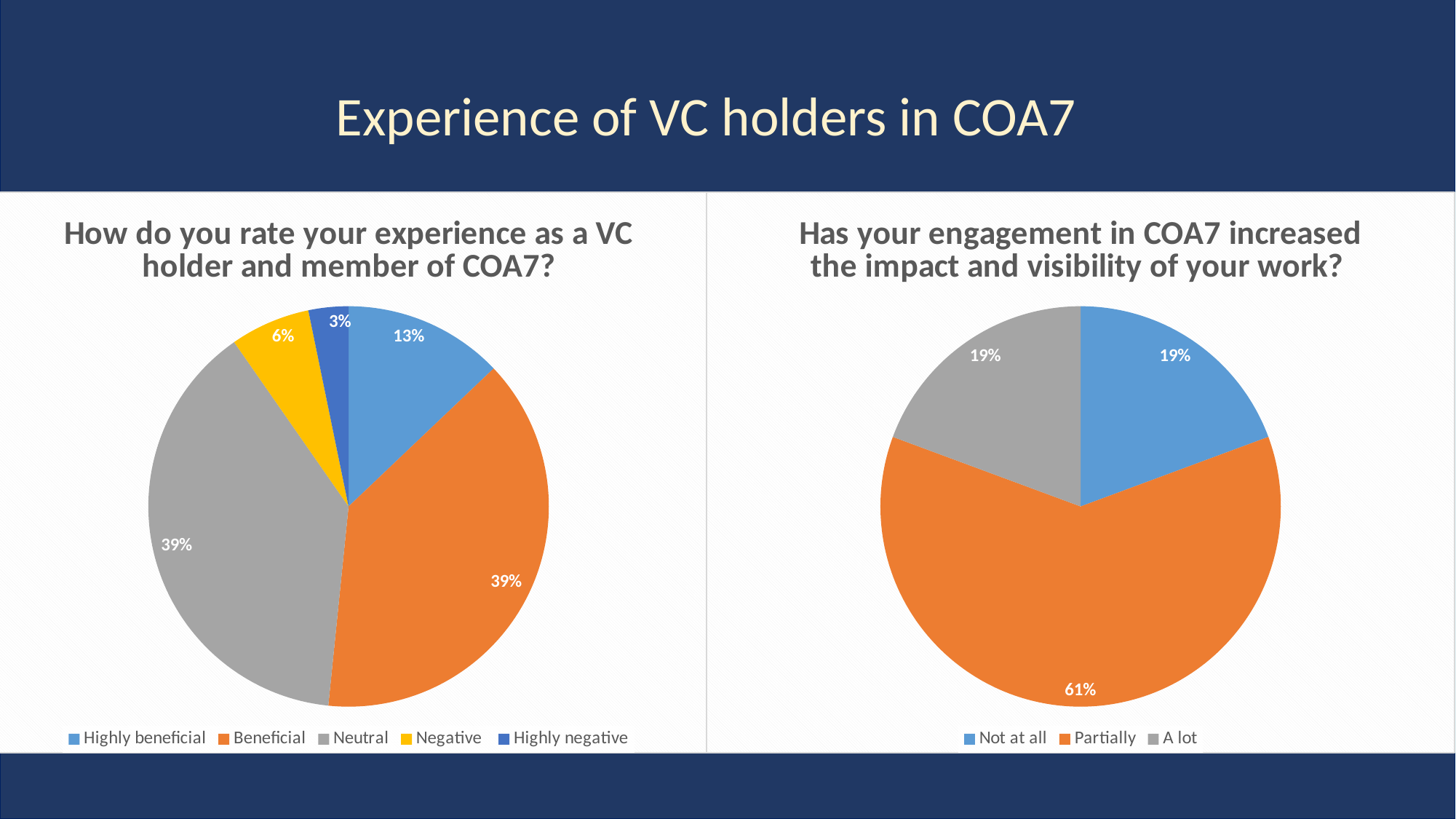
In the right chart ("Has your engagement in COA7 increased the impact and visibility of your work?"), which category has the largest slice? Partially In the right chart ("Has your engagement in COA7 increased the impact and visibility of your work?"), what share is labelled for Not at all? 19% In the left chart ("How do you rate your experience as a VC holder and member of COA7?"), what share is labelled for Highly beneficial? 13% In the right chart ("Has your engagement in COA7 increased the impact and visibility of your work?"), how many categories does the legend list? 3 In the right chart ("Has your engagement in COA7 increased the impact and visibility of your work?"), what share is labelled for Partially? 61% In the left chart ("How do you rate your experience as a VC holder and member of COA7?"), which is larger, Highly beneficial or Negative? Highly beneficial In the left chart ("How do you rate your experience as a VC holder and member of COA7?"), what share is labelled for Highly negative? 3% In the left chart ("How do you rate your experience as a VC holder and member of COA7?"), how many categories does the legend list? 5 In the left chart ("How do you rate your experience as a VC holder and member of COA7?"), what is the difference between the Highly beneficial and Negative shares? 7% In the left chart ("How do you rate your experience as a VC holder and member of COA7?"), what share is labelled for Negative? 6% In the left chart ("How do you rate your experience as a VC holder and member of COA7?"), which category has the smallest slice? Highly negative What kind of chart is the right chart ("Has your engagement in COA7 increased the impact and visibility of your work?")? Pie chart